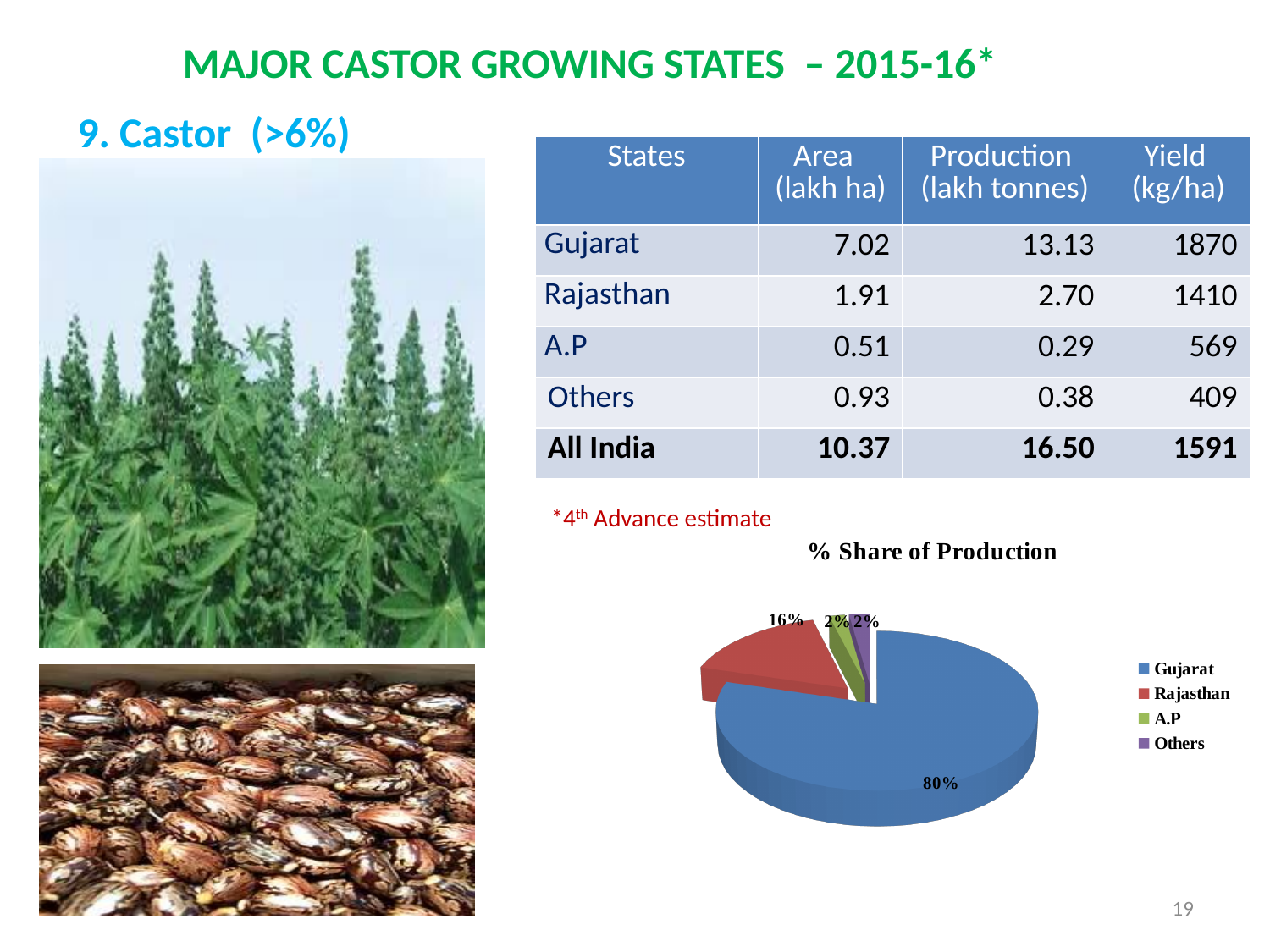
In the pie chart, what is the share of production for Gujarat? 80% In the pie chart, what is the share of production for Others? 2% How many slices does the '% Share of Production' pie chart have? 4 In the pie chart, what is the difference in percentage points between Gujarat's share and Rajasthan's share? 64 percentage points What is the title of the pie chart on the slide? % Share of Production What type of chart is shown under the title '% Share of Production'? Pie chart Which state has the largest slice in the '% Share of Production' pie chart? Gujarat In the pie chart, what is the share of production for Rajasthan? 16% In the pie chart, which has a larger share of production, Gujarat or Rajasthan? Gujarat In the pie chart legend, which state is represented by the red colour? Rajasthan How many entries does the legend of the pie chart list? 4